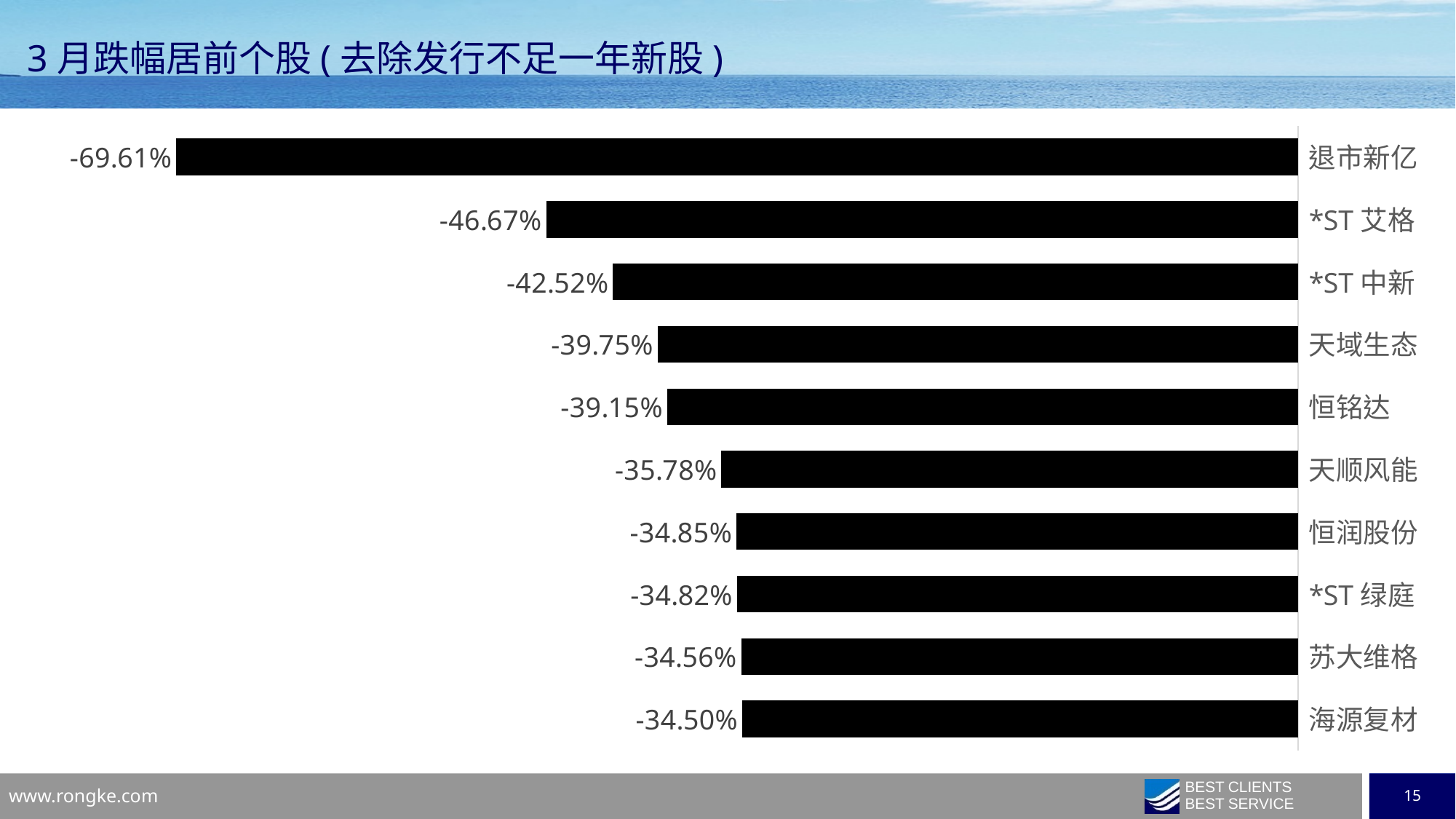
How many stocks are shown in the chart? 10 What is the value for 退市新亿? -69.61% What is the value for 海源复材? -34.50% Which stock has the largest decline (lowest value) in the chart? 退市新亿 What is the difference between the values for *ST 中新 and 天域生态? 2.77 percentage points Which stock has the smallest decline (highest value) in the chart? 海源复材 What is the difference between the values for 退市新亿 and *ST 艾格? 22.94 percentage points What is the value for *ST 艾格? -46.67% What type of chart is shown on the slide? Bar chart What is the title of the slide? 3 月跌幅居前个股 ( 去除发行不足一年新股 ) Which stock fell more in March, 恒铭达 or 天顺风能? 恒铭达 What is the value for 天域生态? -39.75%